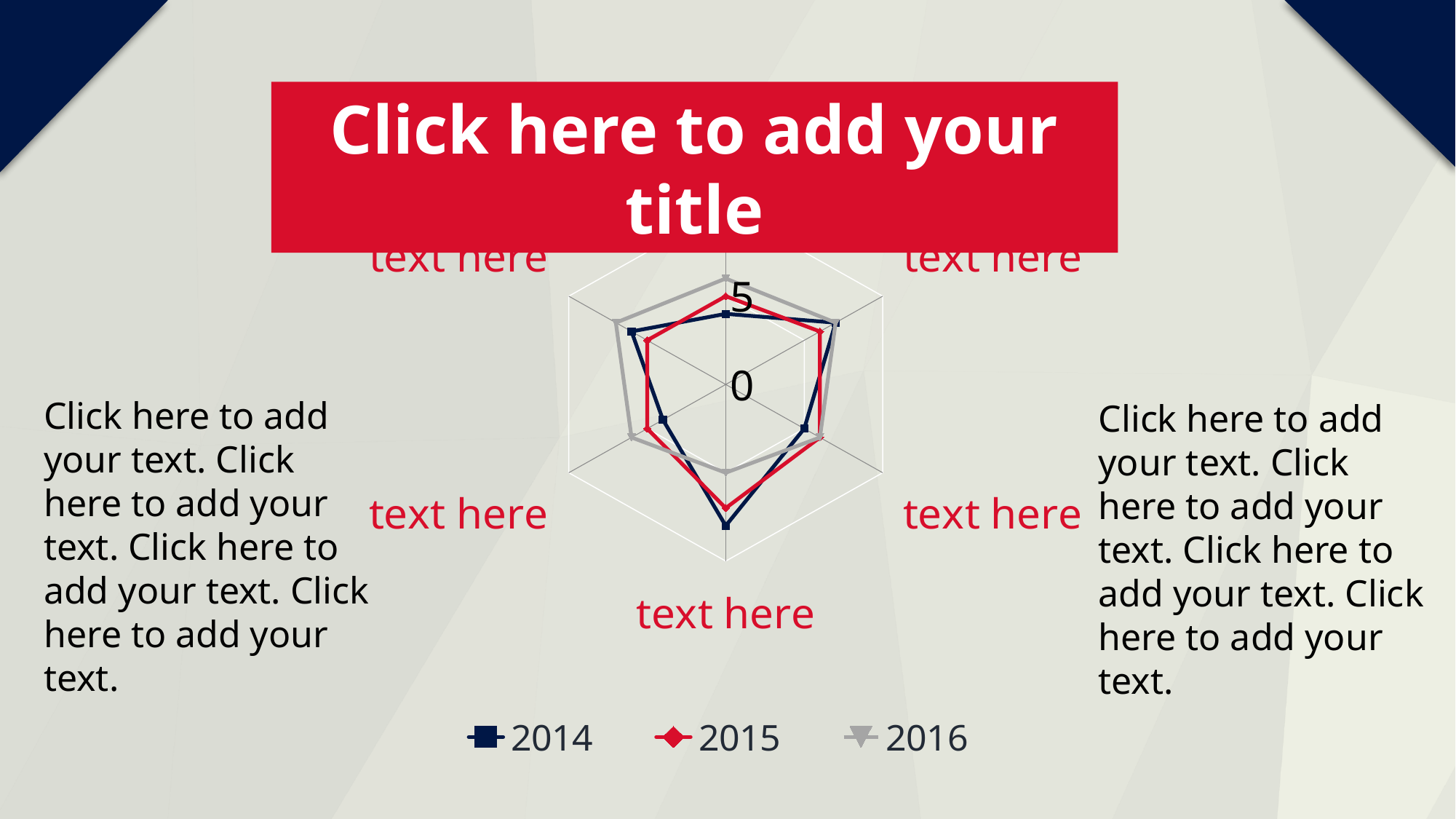
Which series is drawn in red on the chart? 2015 How many axes (categories) does the radar chart have? 6 Which series are listed in the chart's legend? 2014, 2015, 2016 What is the lowest value shown on the chart's axis scale? 0 How many series does the chart's legend list? 3 What kind of chart is shown on the slide? radar chart